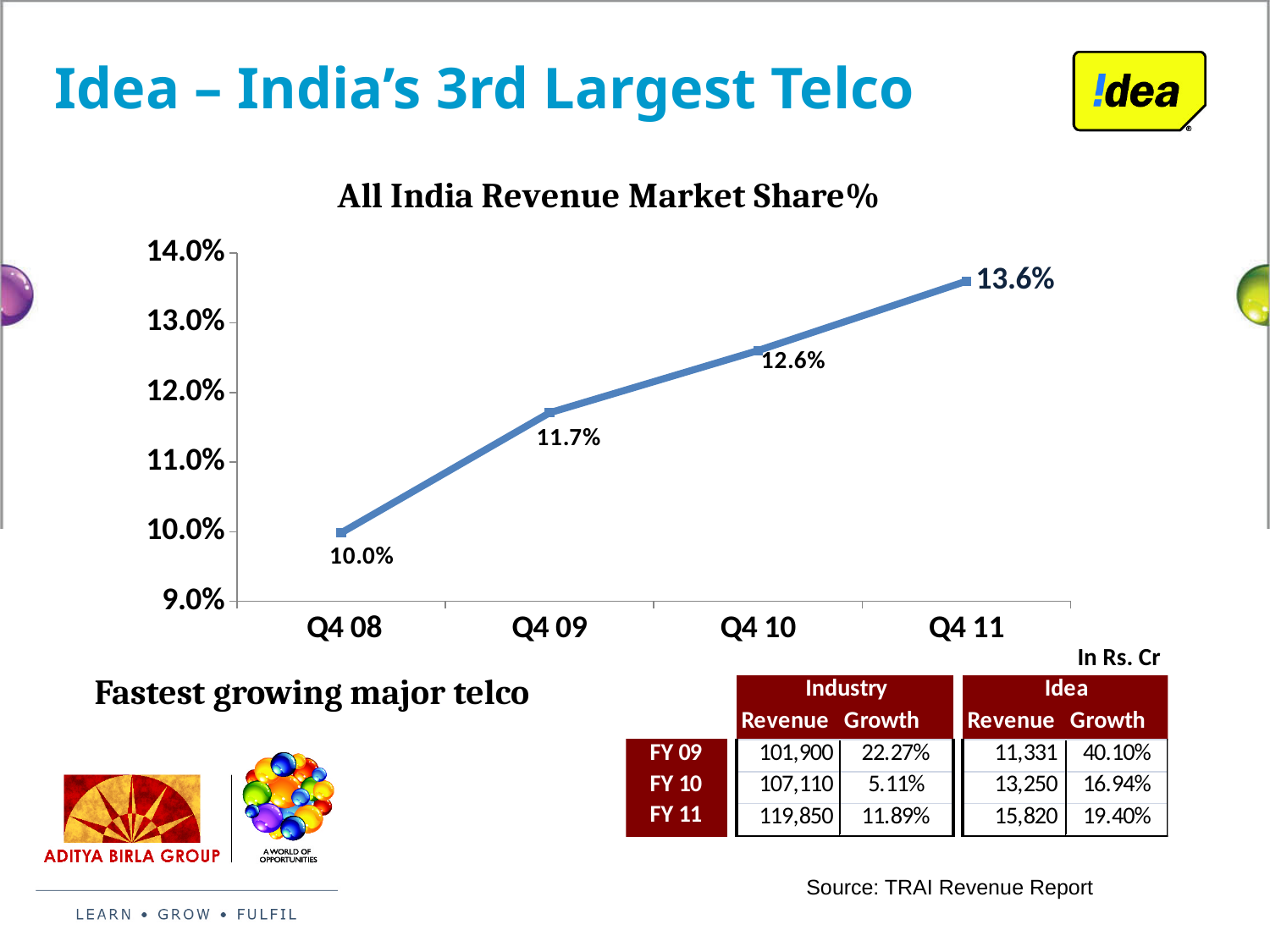
Does the revenue market share rise or fall from Q4 08 to Q4 11? Rise What kind of chart is used to show All India Revenue Market Share%? Line chart What is the All India Revenue Market Share% for Q4 10? 12.6% What is the difference in revenue market share between Q4 11 and Q4 08? 3.6% How many quarters are plotted in the chart? 4 What is the title of the chart on the slide? All India Revenue Market Share% What is the All India Revenue Market Share% for Q4 11? 13.6% What is the All India Revenue Market Share% for Q4 08? 10.0% Which quarter has the lowest revenue market share in the chart? Q4 08 What is the All India Revenue Market Share% for Q4 09? 11.7% Which is larger, the revenue market share in Q4 09 or in Q4 10? Q4 10 Which quarter has the highest revenue market share in the chart? Q4 11